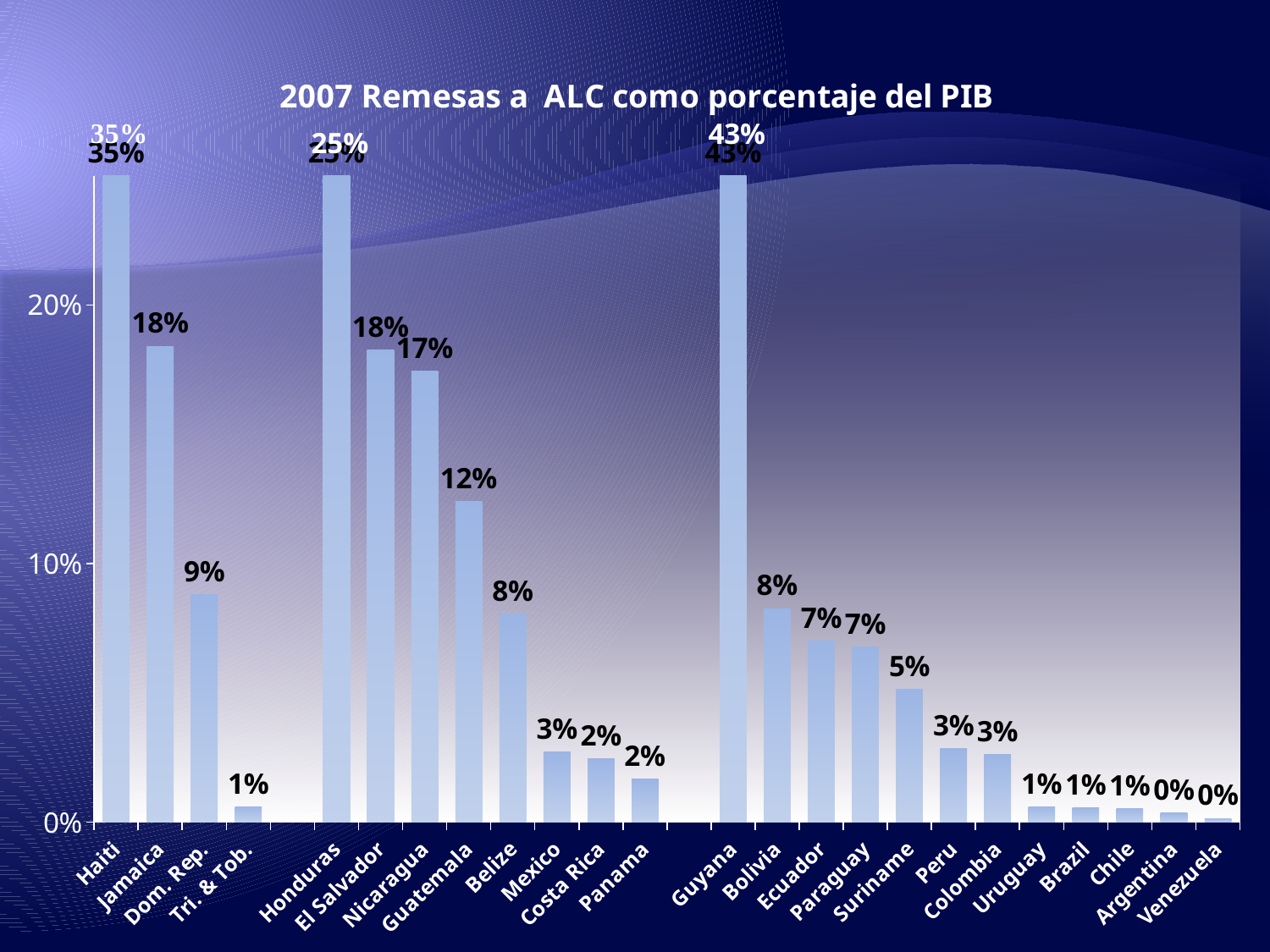
Is the value for Dom. Rep. greater or less than 10%? less What is the title of the chart? 2007 Remesas a ALC como porcentaje del PIB Which is larger, the value for Nicaragua or the value for Guatemala? Nicaragua Which country has the highest value? Guyana What is the difference between the values for Haiti and Honduras? 10 percentage points What is the value for Guyana? 43% What is the difference between the values for Guyana and Bolivia? 35 percentage points What is the value for Haiti? 35% What kind of chart is this? bar chart What is the value for Suriname? 5% How many countries are shown on the x axis? 24 What is the value for Guatemala? 12%